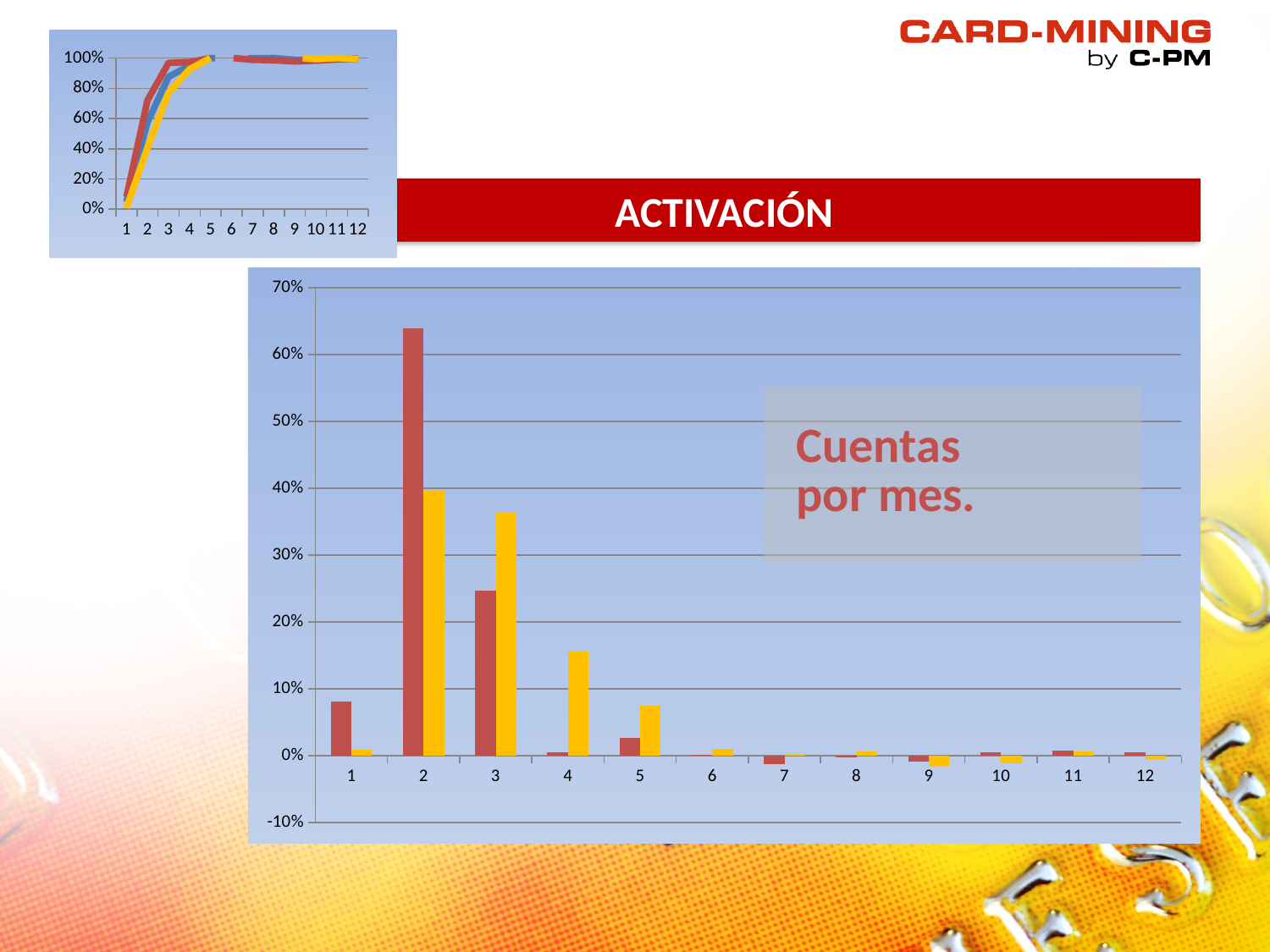
In the small line chart at the top left, do the lines rise or fall from x = 1 to x = 5? rise In the large bar chart, is the red bar for category 2 greater or less than 60%? greater In the large bar chart, which category has the tallest bar? 2 In the small line chart at the top left, how many points are on the x axis? 12 What kind of chart is the small chart at the top left of the slide? line chart In the large bar chart, which bar is taller for category 3, the red one or the yellow one? the yellow one In the large bar chart, which bar is taller for category 2, the red one or the yellow one? the red one In the large bar chart, is the yellow bar for category 3 greater or less than 30%? greater In the large bar chart, how many categories are shown on the x axis? 12 What kind of chart is the large chart in the centre of the slide? bar chart In the large bar chart, is the red bar for category 1 greater or less than 10%? less